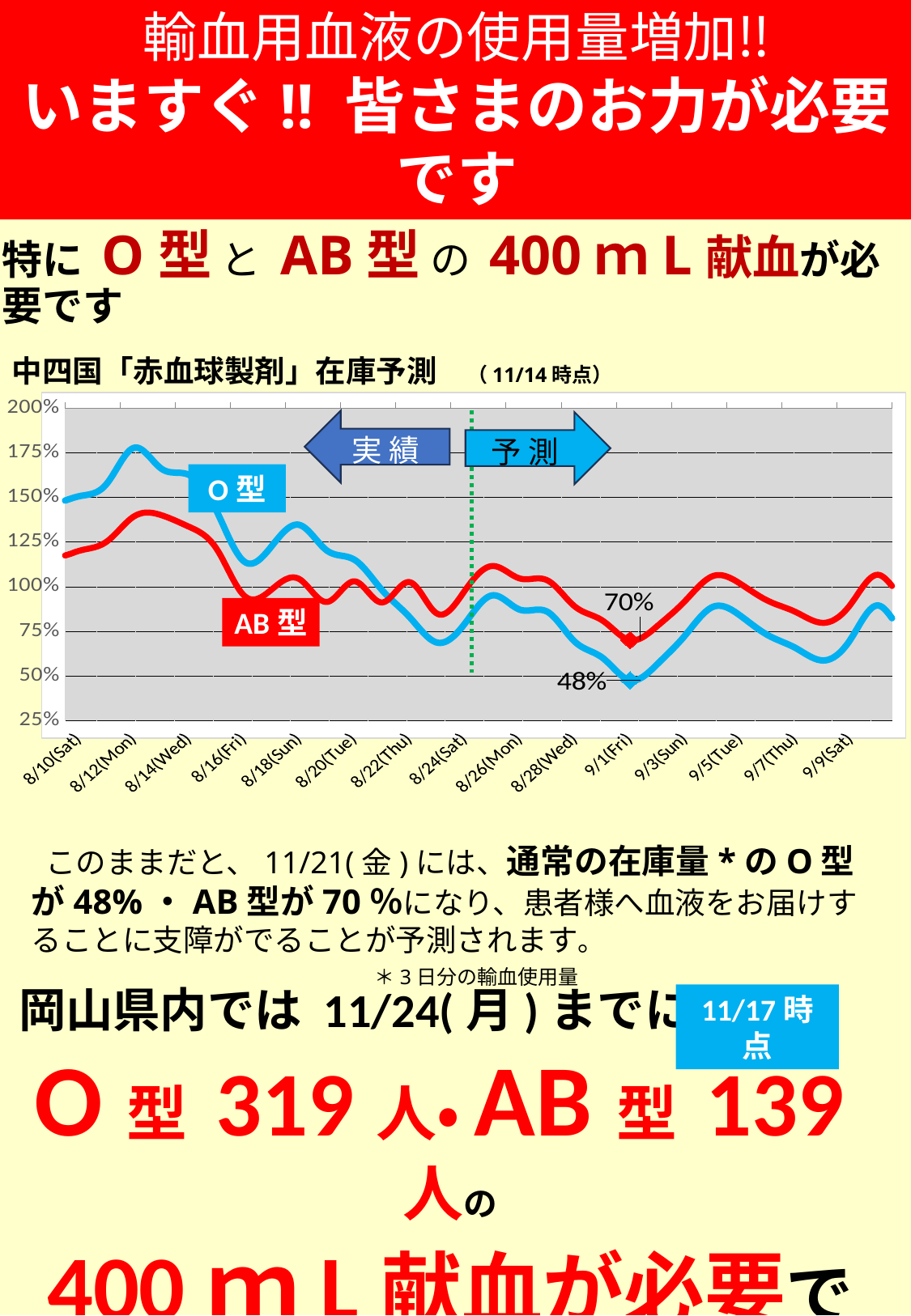
What is the value for AB型 at 9/1(Fri)? 70% What two regions does the green dotted vertical line separate in the chart? 実績 and 予測 How many data series are plotted in the chart? 2 Is the value for O型 at 9/7(Thu) greater or less than 75%? less Is the value for O型 at 8/12(Mon) greater or less than 150%? greater At 9/1(Fri), which series has the higher value, O型 or AB型? AB型 What is the value for O型 at 9/1(Fri)? 48% Is the value for AB型 at 8/10(Sat) greater or less than 100%? greater How many date labels are shown on the x axis? 15 What is the difference between the AB型 and O型 values at 9/1(Fri)? 22 percentage points What type of chart is shown on the slide? line chart At 8/10(Sat), which series has the higher value, O型 or AB型? O型